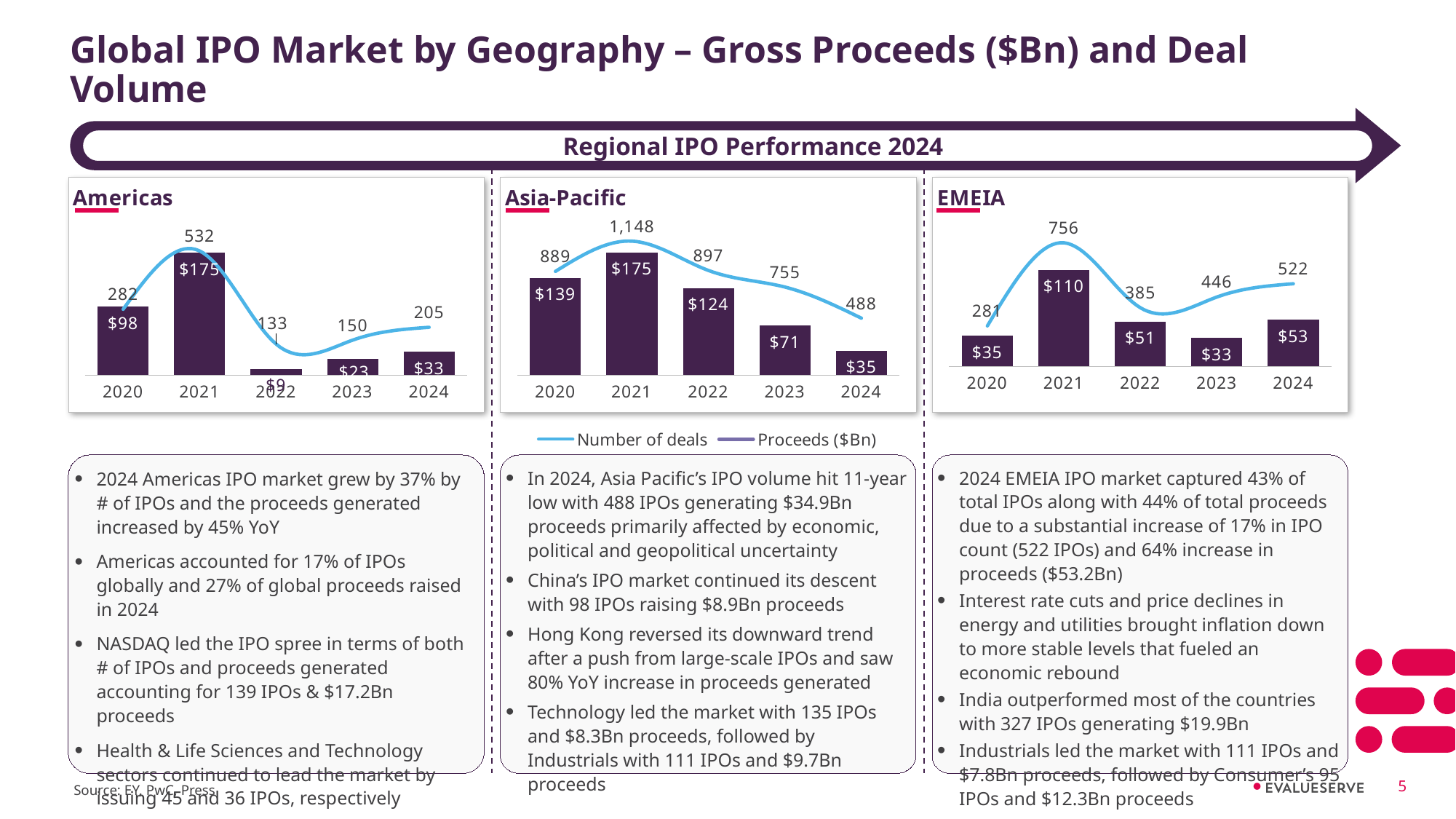
In the Americas chart, what were the proceeds in 2021? $175 What type of chart is used for the Proceeds ($Bn) series in each regional chart? Bar chart In the Asia-Pacific chart, how do proceeds change from 2021 to 2024? They fall How many series does the legend list? 2 In the EMEIA chart, were proceeds higher in 2022 or in 2023? 2022 In the Asia-Pacific chart, what was the number of deals in 2021? 1,148 In the EMEIA chart, what is the difference in number of deals between 2024 and 2023? 76 How many years are shown on the x axis of the Americas chart? 5 In the Americas chart, which year had the lowest proceeds? 2022 In the Asia-Pacific chart, what is the difference in proceeds between 2020 and 2024? $104 In the Asia-Pacific chart, which year had the highest number of deals? 2021 In the EMEIA chart, what were the proceeds in 2024? $53